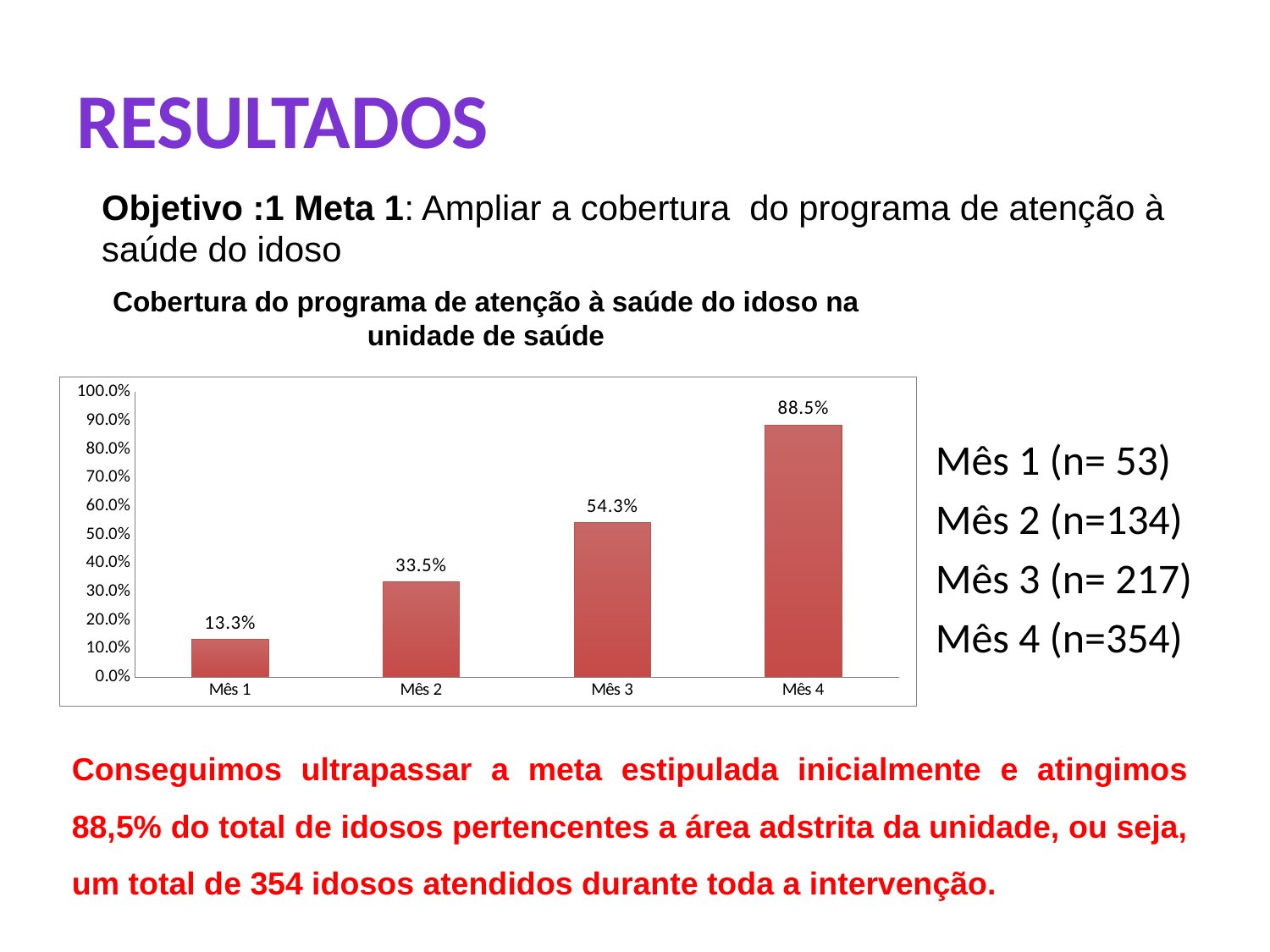
What is the value for Mês 2? 33.5% Which month has the lowest value? Mês 1 What is the difference between the values for Mês 2 and Mês 1? 20.2% What is the value for Mês 1? 13.3% How many categories are shown on the x axis? 4 What is the difference between the values for Mês 4 and Mês 3? 34.2% What is the value for Mês 4? 88.5% What is the value for Mês 3? 54.3% Which is larger, the value for Mês 2 or the value for Mês 3? Mês 3 What kind of chart is shown? Bar chart Which month has the highest value? Mês 4 Do the values rise or fall from Mês 1 to Mês 4? Rise